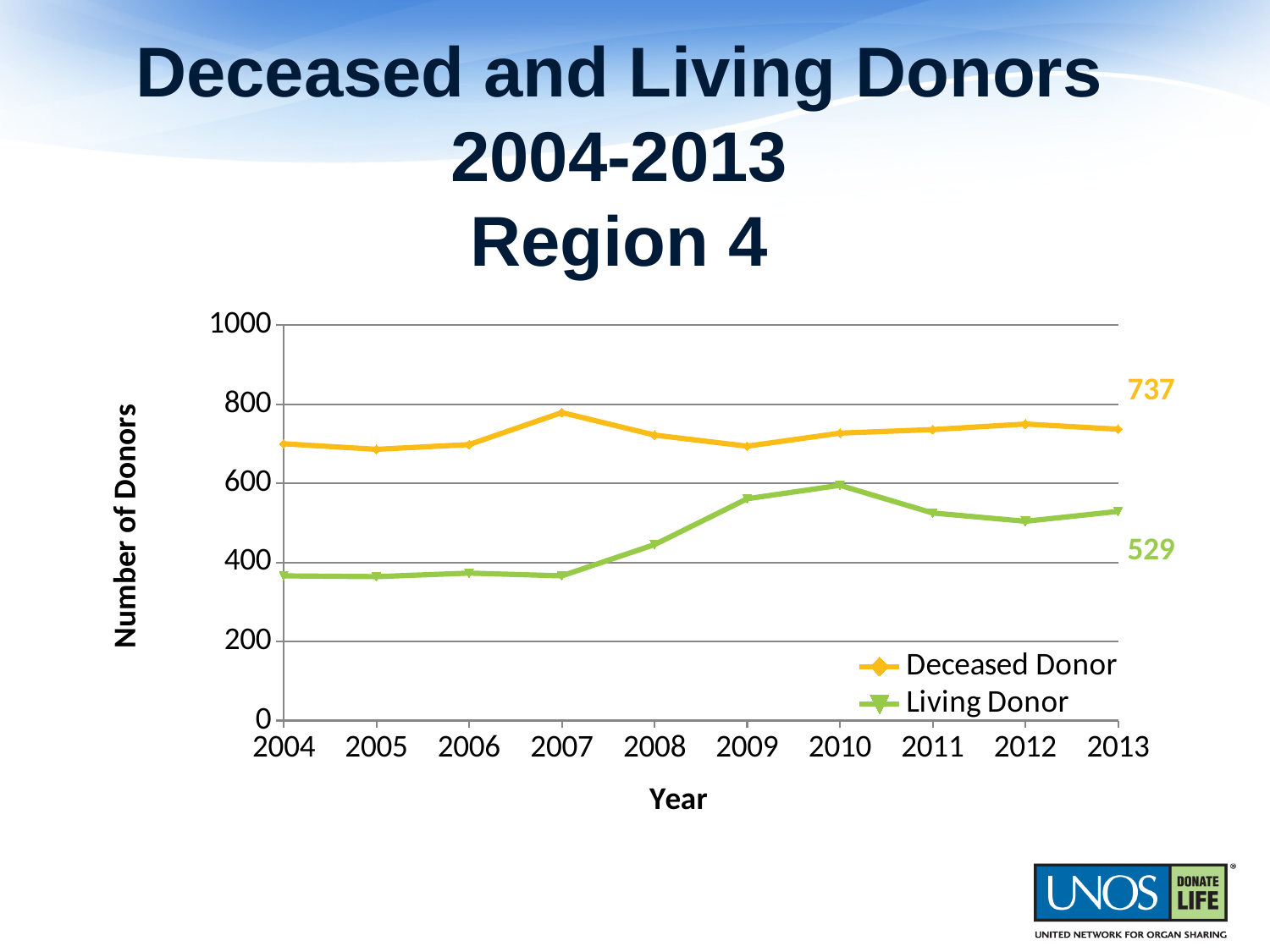
How many series does the legend list? 2 Does the Living Donor series rise or fall from 2007 to 2010? Rise What kind of chart is shown on the slide? Line chart What is the difference between the Deceased Donor and Living Donor values in 2013? 208 What is the value for Living Donor in 2013? 529 In which year does the Living Donor series reach its highest value? 2010 Is the value for Deceased Donor in 2007 greater or less than 600? greater In 2013, which series has the larger value, Deceased Donor or Living Donor? Deceased Donor How many years are shown on the x axis? 10 Is the value for Living Donor in 2004 greater or less than 400? less In which year does the Deceased Donor series reach its highest value? 2007 What is the value for Deceased Donor in 2013? 737